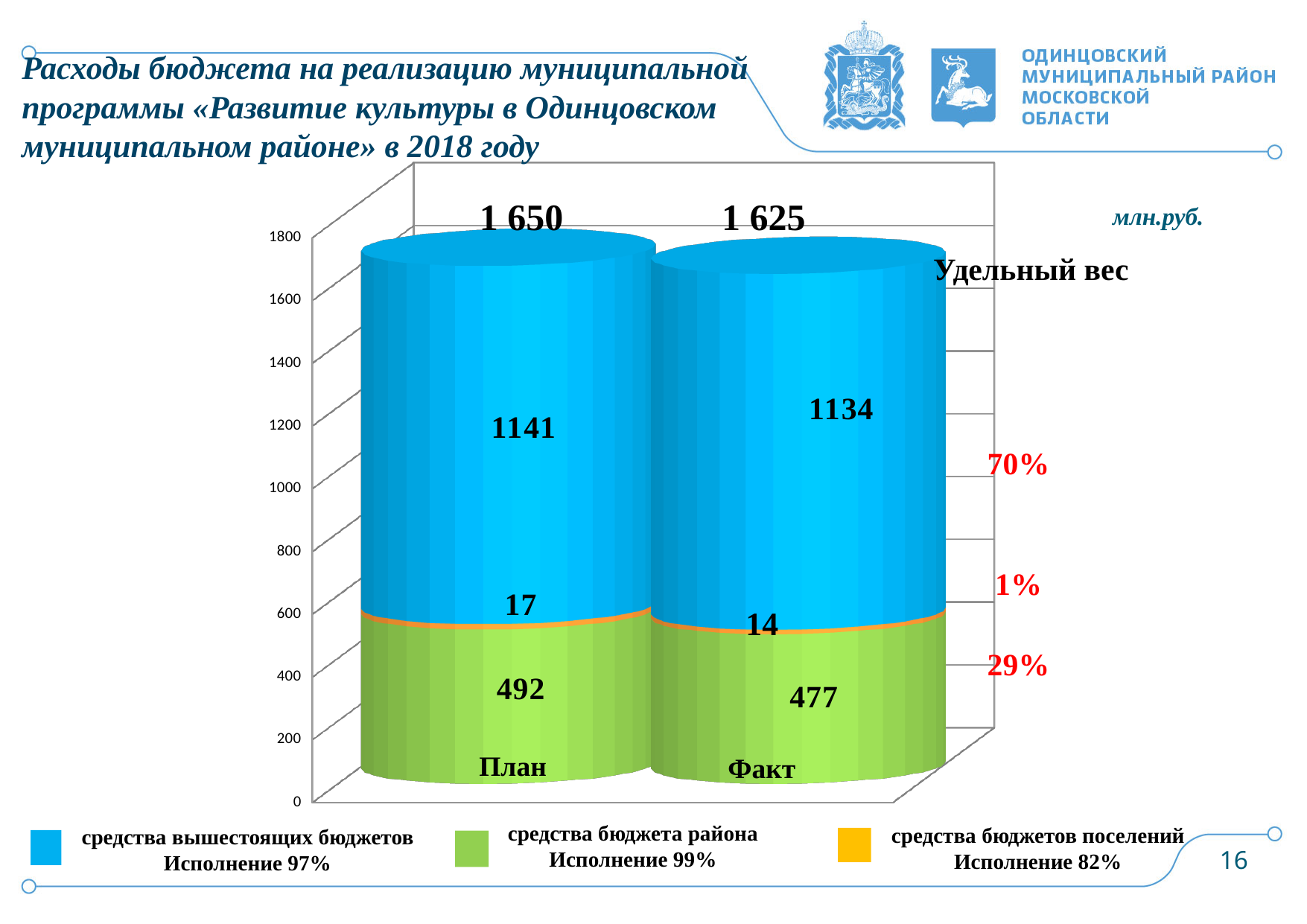
What is the total shown above the План bar? 1 650 What is the difference between средства бюджета района for План and for Факт? 15 What is the value of средства вышестоящих бюджетов for План? 1141 How many series does the legend list? 3 What is the total shown above the Факт bar? 1 625 What is the value of средства бюджета района for Факт? 477 What share (Удельный вес) is shown for средства вышестоящих бюджетов? 70% What unit is indicated for the chart values? млн.руб. Which is larger, средства вышестоящих бюджетов for План or for Факт? План What kind of chart is shown on the slide? Stacked bar chart What is the value of средства бюджетов поселений for План? 17 How many categories are shown on the x axis? 2